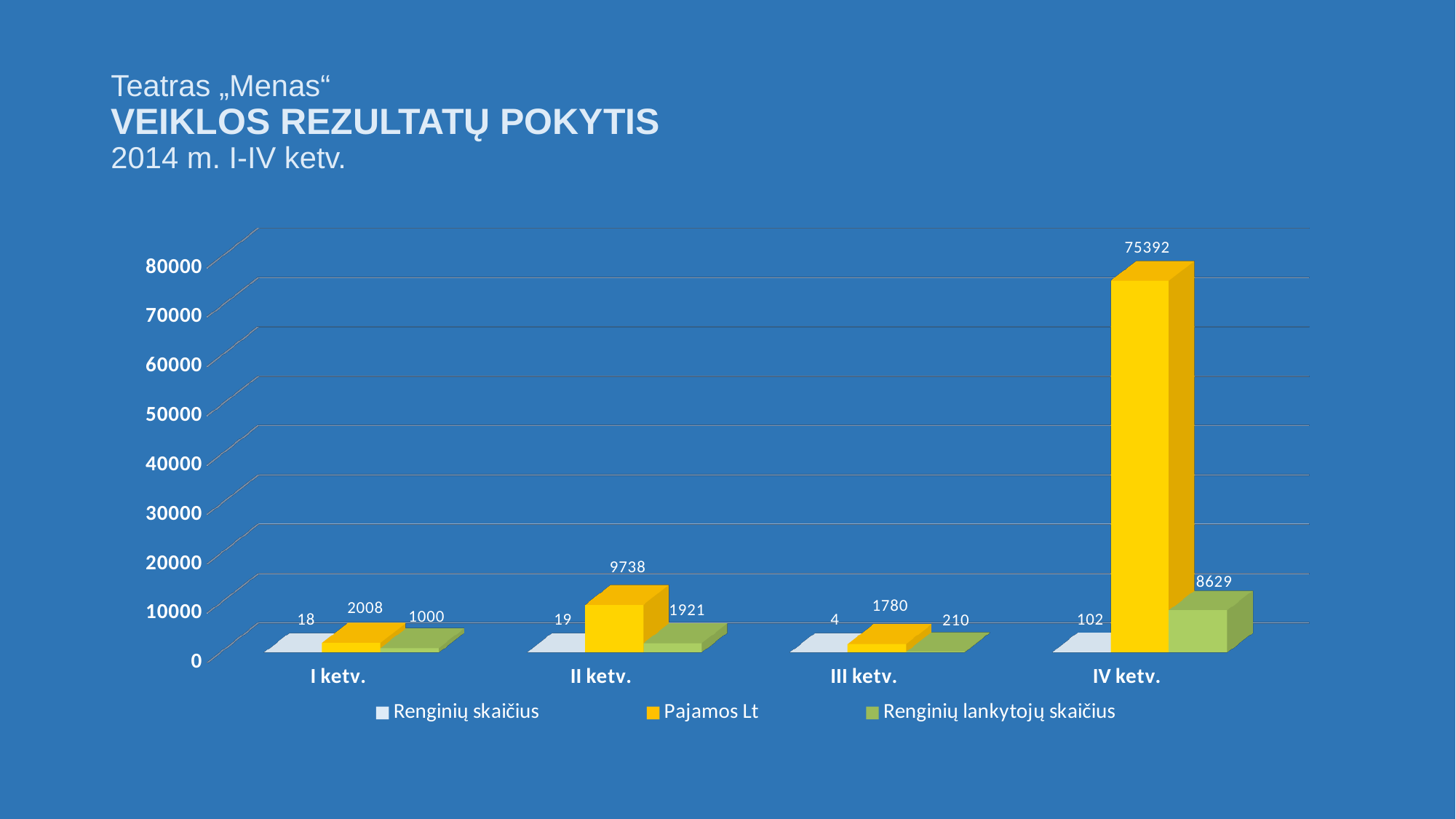
Which series is shown in yellow in the legend? Pajamos Lt What is the value of Renginių skaičius for III ketv.? 4 Is the value of Pajamos Lt for IV ketv. greater or less than 70000? greater What is the value of Renginių lankytojų skaičius for II ketv.? 1921 What kind of chart is shown on the slide? bar chart Which is larger: Renginių lankytojų skaičius for I ketv. or for II ketv.? II ketv. What is the difference between Pajamos Lt for IV ketv. and II ketv.? 65654 How many series does the legend list? 3 Which quarter has the lowest Renginių lankytojų skaičius value? III ketv. How many quarters (categories) are shown on the x axis? 4 Which quarter has the highest Pajamos Lt value? IV ketv. What is the value of Pajamos Lt for IV ketv.? 75392